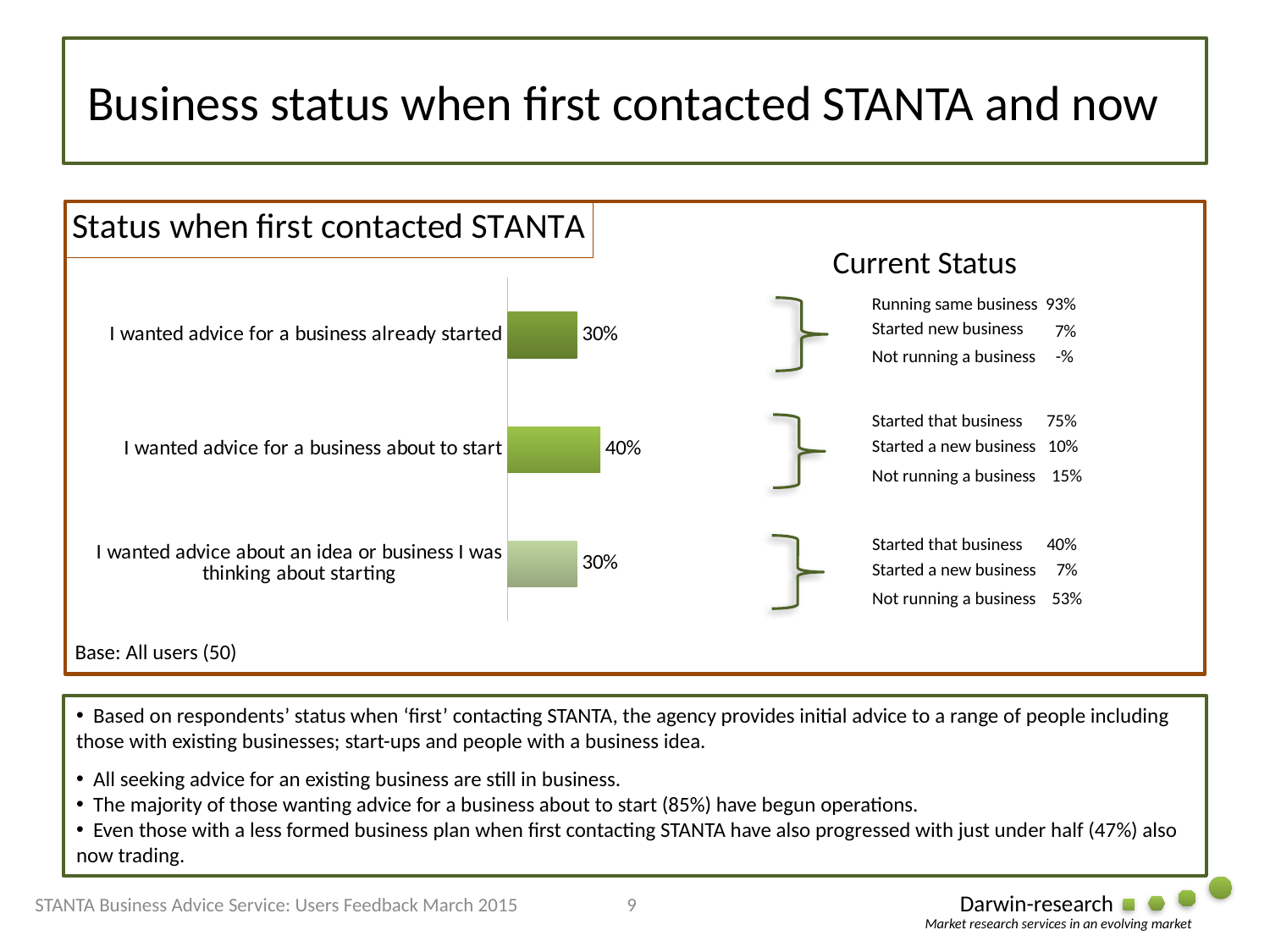
Which is larger: the value for 'I wanted advice for a business about to start' or 'I wanted advice for a business already started'? I wanted advice for a business about to start What is the difference between the value for 'I wanted advice for a business about to start' and 'I wanted advice for a business already started'? 10% What is the title of the chart? Status when first contacted STANTA Is the value for 'I wanted advice for a business about to start' greater or less than 30%? greater What kind of chart is shown on the slide? bar chart Which category has the highest value in the chart? I wanted advice for a business about to start What is the base stated below the chart? All users (50) What percentage of users wanted advice for a business about to start? 40% What percentage of users wanted advice about an idea or business they were thinking about starting? 30% How many categories (bars) are shown in the chart? 3 What percentage of users wanted advice for a business already started? 30%